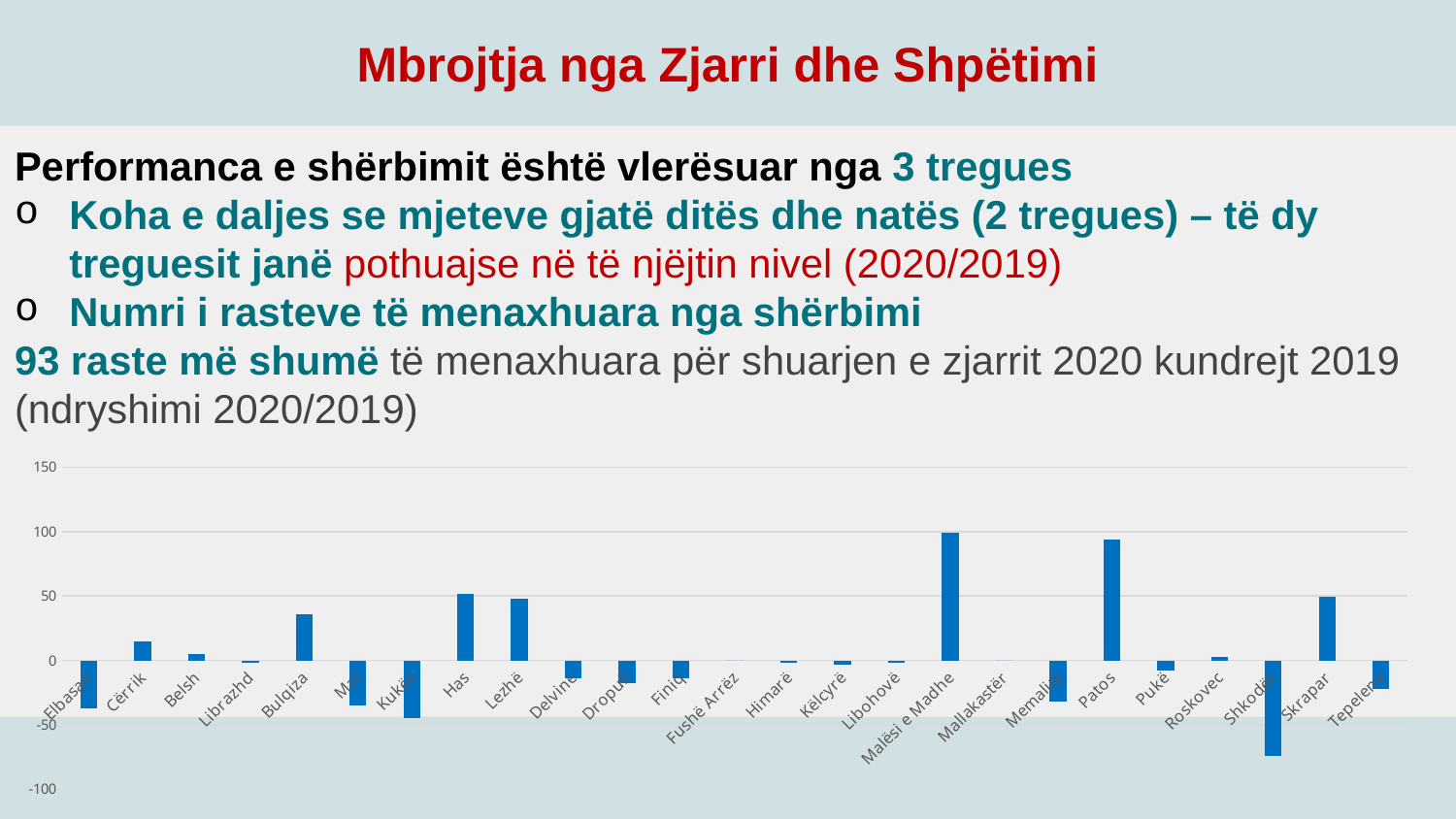
What kind of chart is shown on the slide? bar chart Is the value for Malësi e Madhe greater or less than 50? greater Is the value for Patos greater or less than 50? greater Which category has the lowest value in the chart? Shkodër Is the value for Bulqiza greater or less than 50? less How many categories are shown on the x axis of the chart? 25 Which is larger, the value for Lezhë or the value for Cërrik? Lezhë What is the highest value shown on the chart's vertical axis? 150 Which is larger, the value for Has or the value for Bulqiza? Has